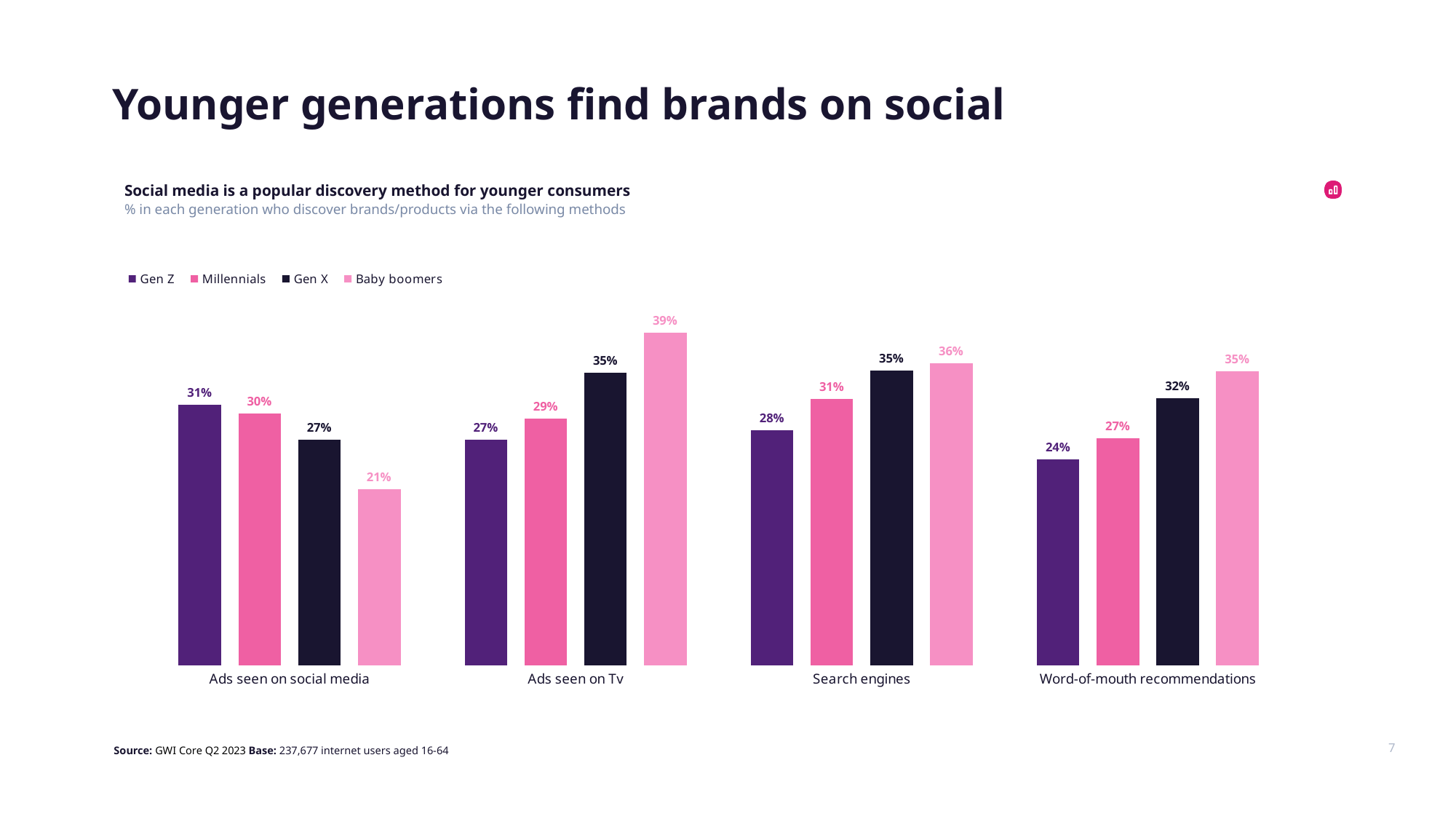
What is the difference between the Baby boomers and Gen Z values for Ads seen on Tv? 12% What is the difference between the Millennials and Gen Z values for Search engines? 3% How many discovery methods are shown on the x axis? 4 Which generation has the highest value for Search engines? Baby boomers What is the title of the chart? Social media is a popular discovery method for younger consumers What is the value for Baby boomers under Ads seen on Tv? 39% Which is larger for Word-of-mouth recommendations: the Gen Z value or the Baby boomers value? Baby boomers Which generation has the lowest value for Ads seen on social media? Baby boomers What percentage of Gen Z discover brands via ads seen on social media? 31% How many series does the legend list? 4 What percentage of Gen X discover brands via word-of-mouth recommendations? 32% What kind of chart is shown on the slide? Bar chart